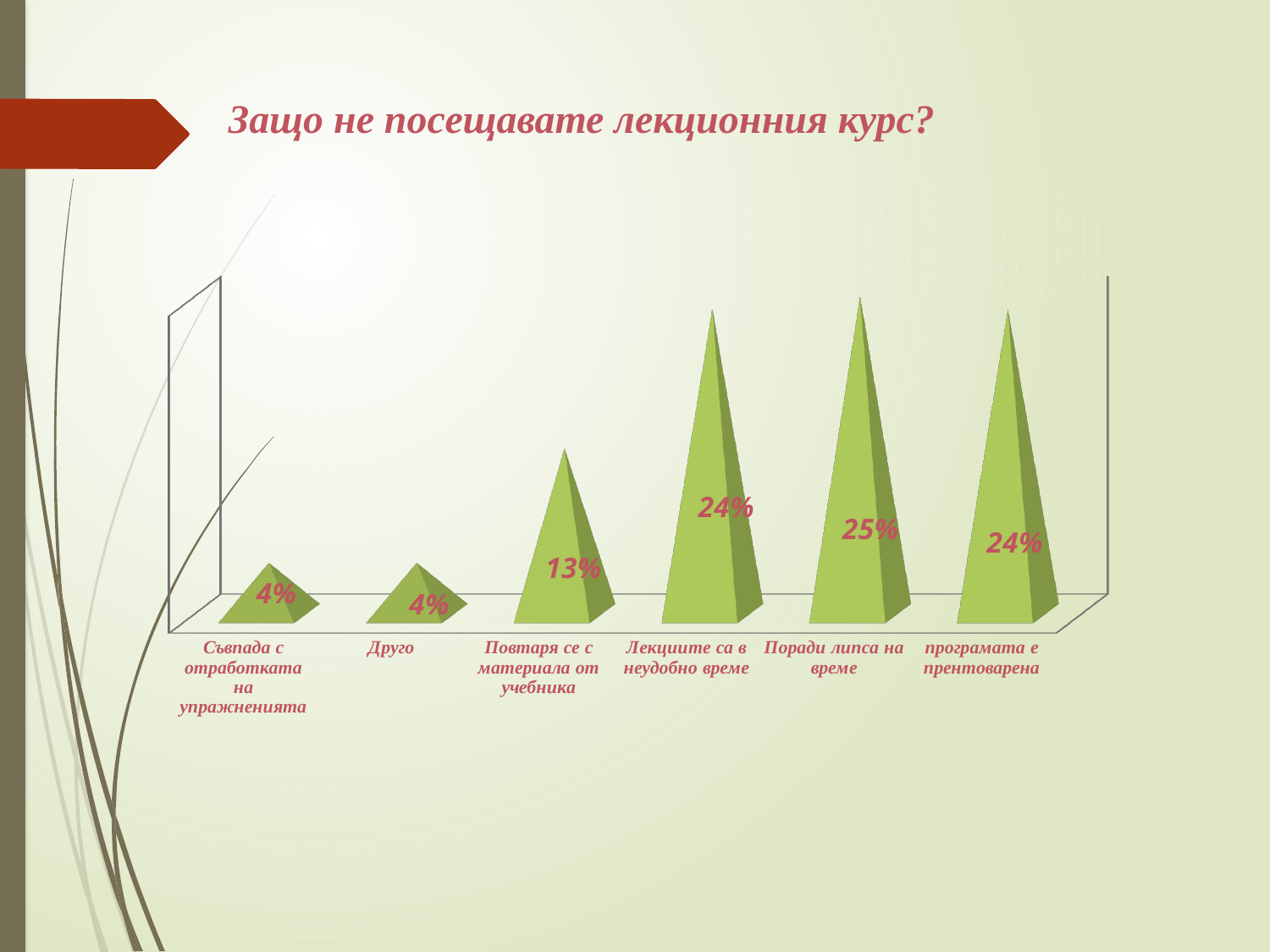
What type of chart is shown on the slide? bar chart What is the value for "Друго"? 4% What is the value for "програмата е прентоварена"? 24% What is the title of the chart? Защо не посещавате лекционния курс? How many categories are shown in the chart? 6 What is the value for "Повтаря се с материала от учебника"? 13% Which is larger: the value for "Повтаря се с материала от учебника" or the value for "Съвпада с отработката на упражненията"? Повтаря се с материала от учебника What is the value for "Поради липса на време"? 25% What is the value for "Лекциите са в неудобно време"? 24% What is the difference between the values for "Лекциите са в неудобно време" and "Друго"? 20% What is the difference between the values for "Поради липса на време" and "Повтаря се с материала от учебника"? 12% Which category has the highest value? Поради липса на време